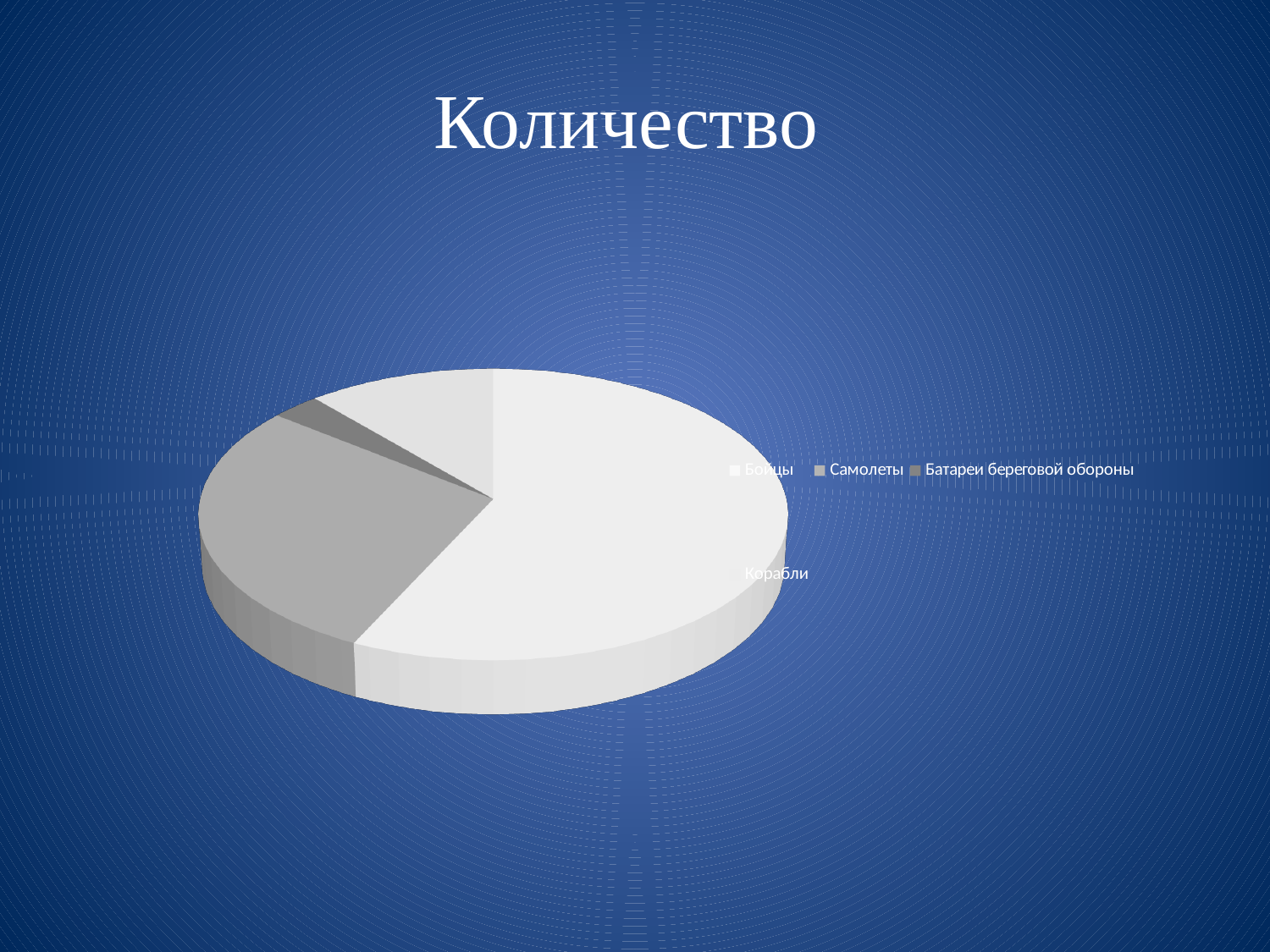
Which slice is larger, Бойцы or Корабли? Бойцы Which slice is larger, Самолеты or Батареи береговой обороны? Самолеты How many entries does the chart legend list? 4 How many slices does the pie chart have? 4 Which category has the largest slice of the pie? Бойцы Which category has the smallest slice of the pie? Батареи береговой обороны What is the title of the chart? Количество Which legend entry is listed first in the chart legend? Бойцы Which slice is larger, Бойцы or Самолеты? Бойцы What kind of chart is shown on the slide? pie chart